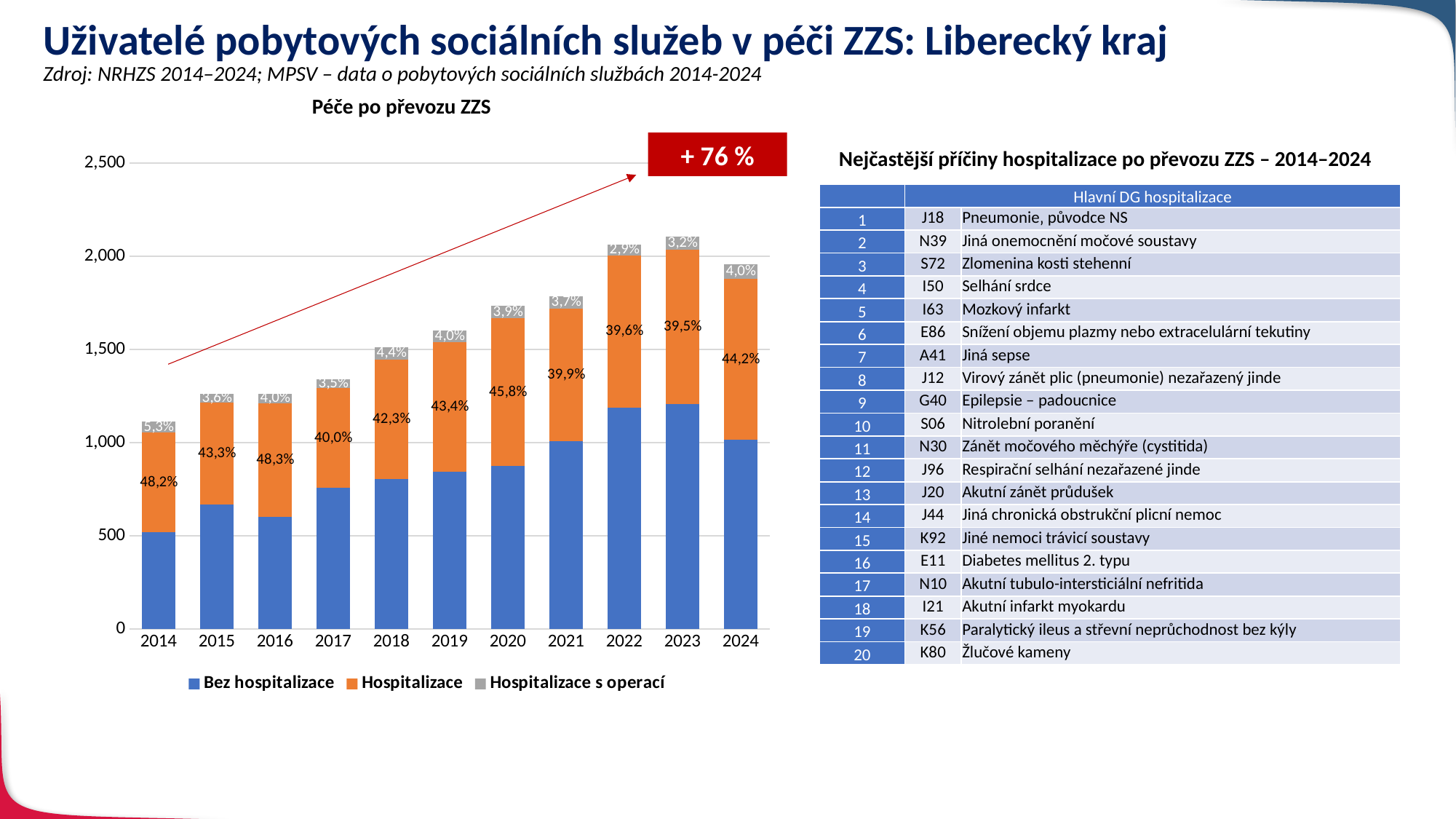
What is the difference between the 'Hospitalizace' labels for 2014 and 2023? 8,7 percentage points How many years are shown on the x axis of the 'Péče po převozu ZZS' chart? 11 How many series does the legend of the 'Péče po převozu ZZS' chart list? 3 What percentage increase is shown in the red annotation box on the chart? + 76 % What type of chart is shown under the title 'Péče po převozu ZZS'? Stacked bar chart In which year is the 'Hospitalizace s operací' label the lowest? 2022 Is the total bar for 2023 greater or less than 2,000? greater What percentage label is shown for 'Hospitalizace s operací' in 2014? 5,3% Which year has the lowest total bar in the 'Péče po převozu ZZS' chart? 2014 What percentage label is shown for 'Hospitalizace' in 2024? 44,2% What percentage label is shown for 'Hospitalizace' in 2017? 40,0% Is the 'Hospitalizace' label larger in 2020 or in 2021? 2020